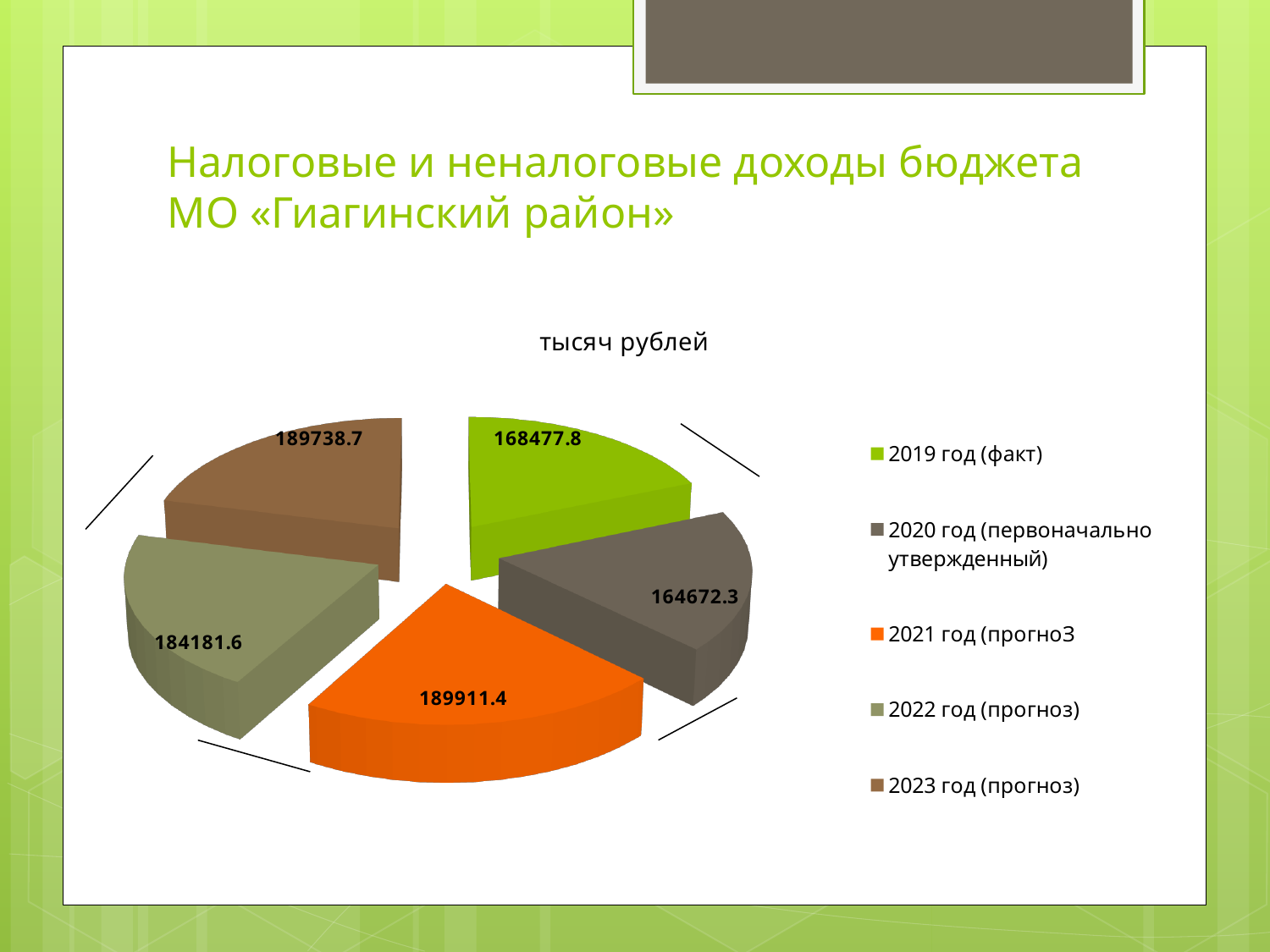
What is the difference between the values for 2021 год (прогноз) and 2020 год (первоначально утвержденный)? 25239.1 Which year has the highest value in the pie chart? 2021 год (прогноз) What is the value for 2019 год (факт)? 168477.8 Which is larger, the value for 2022 год (прогноз) or the value for 2019 год (факт)? 2022 год (прогноз) What is the value for 2022 год (прогноз)? 184181.6 How many slices does the pie chart have? 5 What is the value for 2023 год (прогноз)? 189738.7 What is the value for 2020 год (первоначально утвержденный)? 164672.3 What type of chart is shown on the slide? Pie chart What is the title shown above the pie chart? тысяч рублей Which year has the lowest value in the pie chart? 2020 год (первоначально утвержденный) What is the value for 2021 год (прогноз)? 189911.4